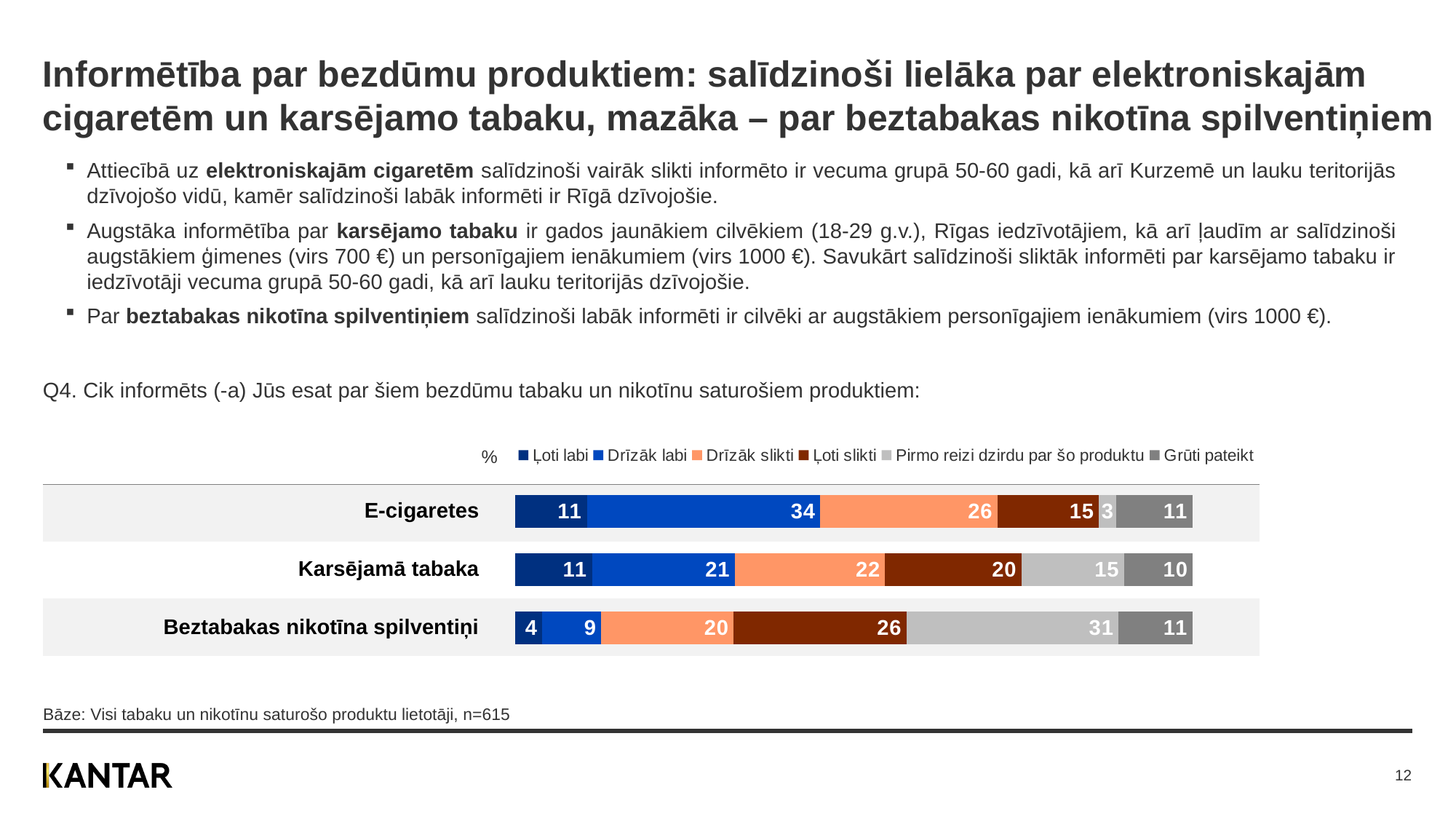
What is the total of the stacked bar for Karsējamā tabaka? 99 Which is larger: the "Ļoti slikti" value for Beztabakas nikotīna spilventiņi or for E-cigaretes? Beztabakas nikotīna spilventiņi Which product has the lowest value for "Pirmo reizi dzirdu par šo produktu"? E-cigaretes What is the value for "Pirmo reizi dzirdu par šo produktu" for Beztabakas nikotīna spilventiņi? 31 What kind of chart is shown on the slide? stacked bar chart Which product has the highest value for "Drīzāk labi"? E-cigaretes What is the difference between the "Drīzāk labi" values for E-cigaretes and Karsējamā tabaka? 13 What is the value for "Drīzāk labi" for E-cigaretes? 34 How many product categories are plotted in the chart? 3 What is the value for "Ļoti labi" for Beztabakas nikotīna spilventiņi? 4 How many series does the legend list? 6 What is the value for "Ļoti slikti" for Karsējamā tabaka? 20